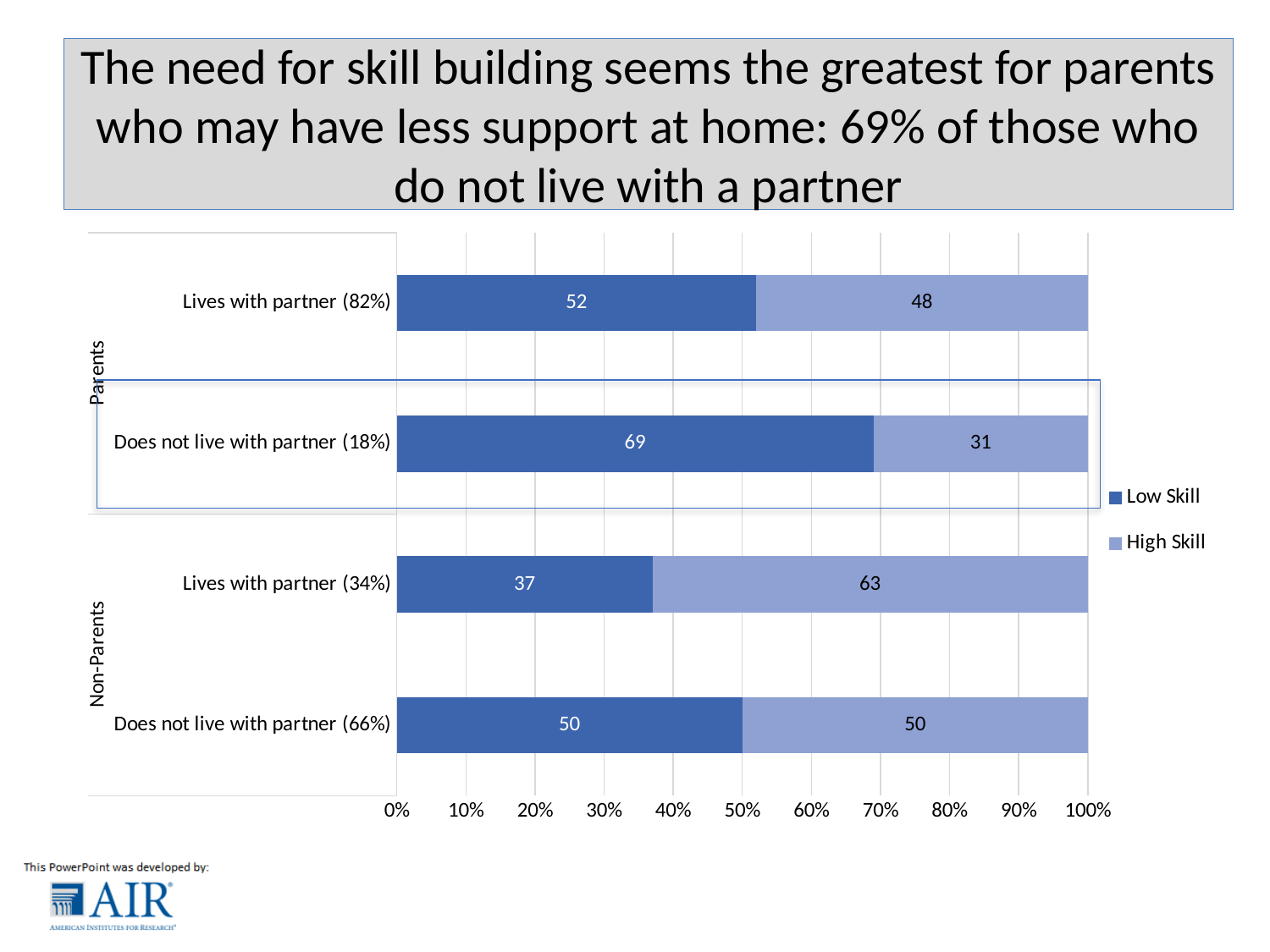
Which is larger: the High Skill value for Parents who live with a partner or the High Skill value for Non-Parents who live with a partner? Non-Parents who live with a partner How many series does the legend list? 2 What kind of chart is shown on the slide? Stacked bar chart What is the Low Skill value for Parents who do not live with a partner? 69 What is the High Skill value for Non-Parents who live with a partner? 63 Which category has the highest Low Skill value? Parents, Does not live with partner (18%) Which category has the lowest Low Skill value? Non-Parents, Lives with partner (34%) How many categories (bars) are shown in the chart? 4 What are the two series named in the legend? Low Skill and High Skill What is the High Skill value for Non-Parents who do not live with a partner? 50 What is the difference between the Low Skill values for Parents who do not live with a partner and Parents who live with a partner? 17 What is the Low Skill value for Parents who live with a partner? 52